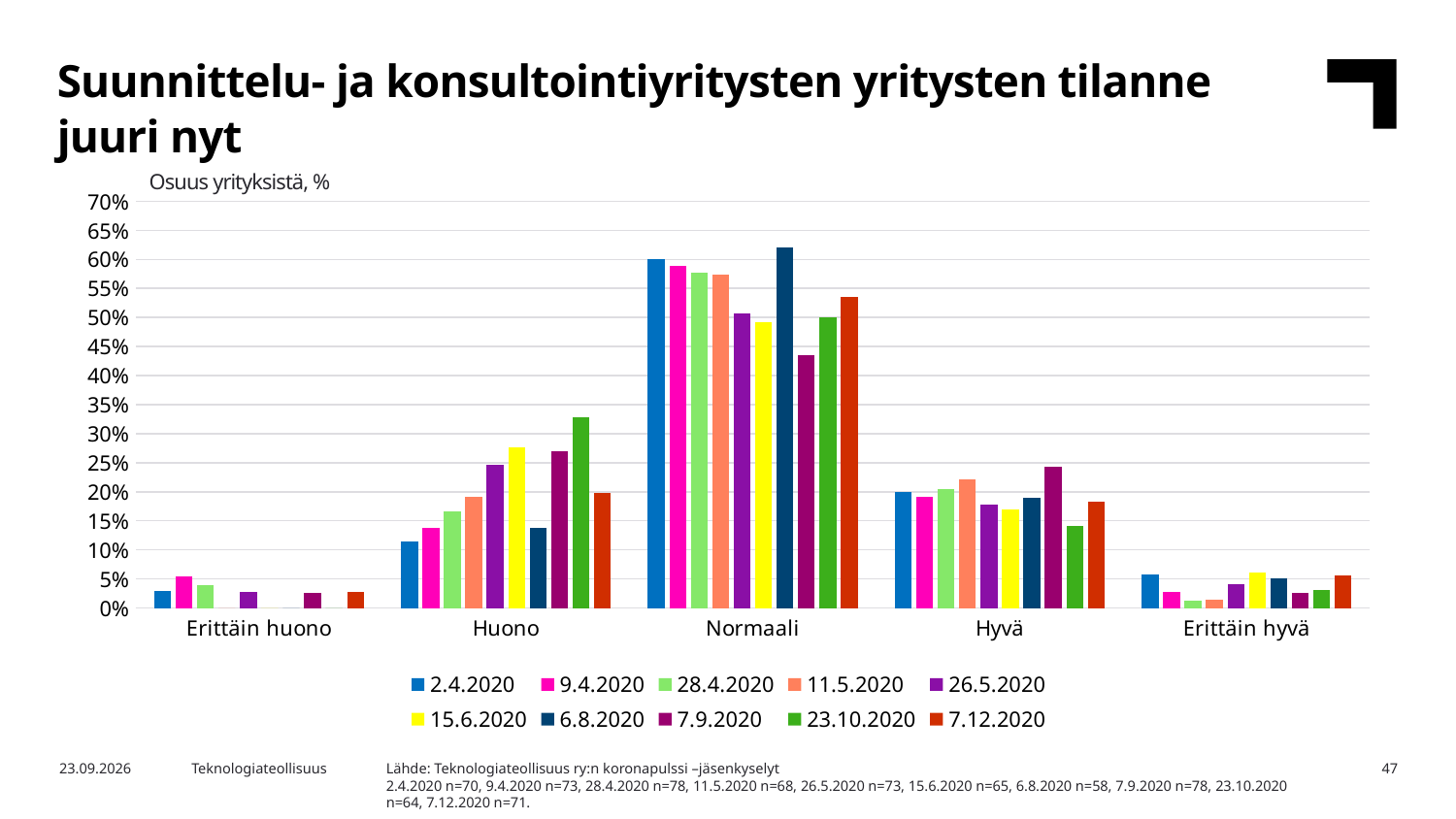
How many categories are shown on the x axis of the chart? 5 Is the value for Normaali in the 6.8.2020 series greater or less than 60%? greater Is the value for Huono in the 23.10.2020 series greater or less than 30%? greater What kind of chart is shown on the slide? bar chart Is the value for Hyvä in the 7.9.2020 series greater or less than 20%? greater For the Normaali category, which series has the lowest value? 7.9.2020 What label is shown above the vertical axis of the chart? Osuus yrityksistä, % Which category has the highest value for the 6.8.2020 series? Normaali For the Huono category, which is larger: the 2.4.2020 value or the 7.12.2020 value? 7.12.2020 For the Huono category, which series has the highest value? 23.10.2020 How many series does the legend list? 10 For the Normaali category, which is larger: the 2.4.2020 value or the 7.9.2020 value? 2.4.2020